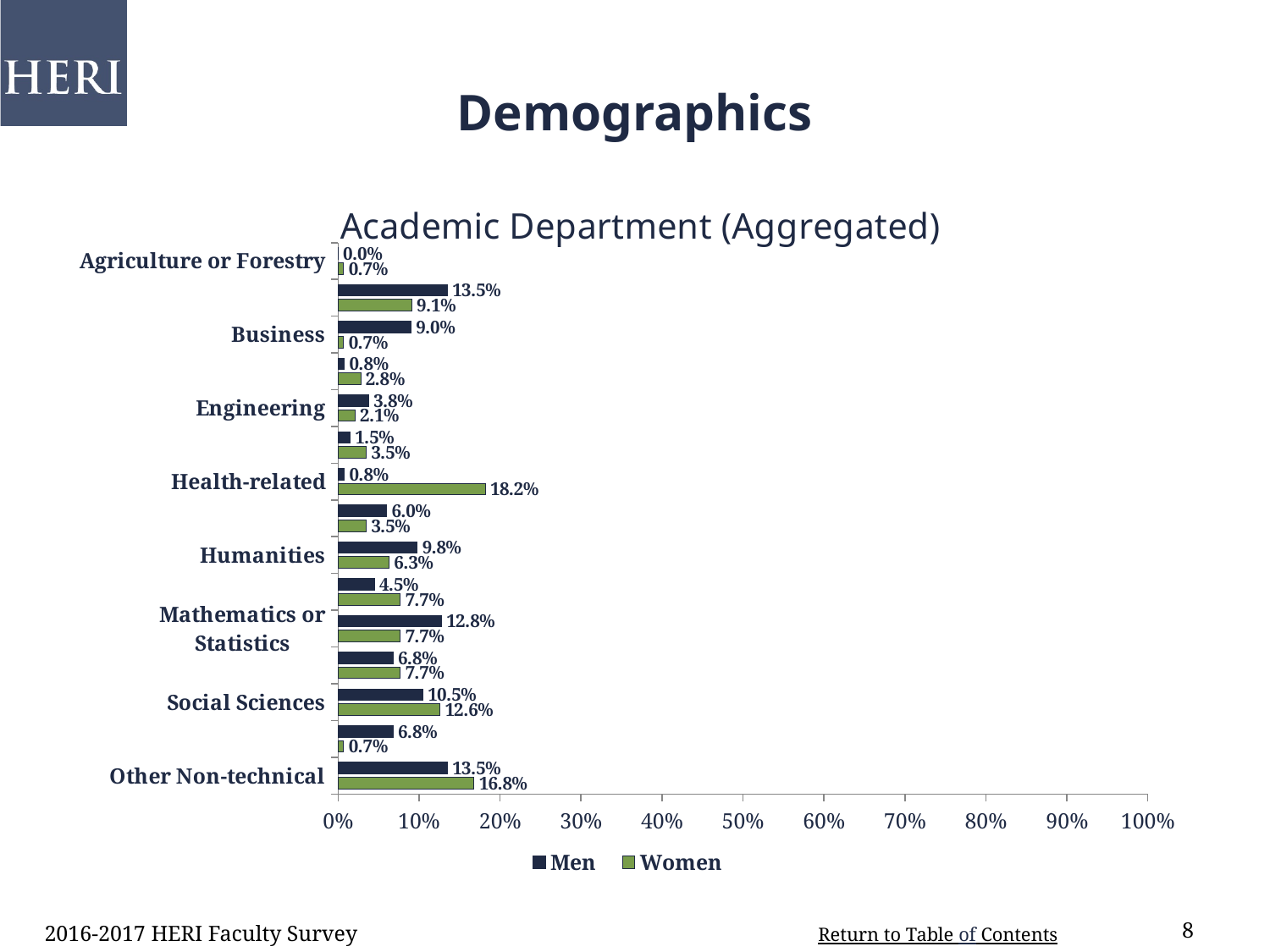
What is the value for Men in Mathematics or Statistics? 12.8% What is the value for Women in Other Non-technical? 16.8% In Social Sciences, which is larger, the value for Men or for Women? Women How many series does the legend list? 2 What kind of chart is shown on the slide? Bar chart What is the value for Men in Business? 9.0% What is the difference between the Men and Women values for Humanities? 3.5% Which labeled department has the lowest value for Men? Agriculture or Forestry What is the difference between the Women and Men values for Health-related? 17.4% Is the value for Women in Health-related greater or less than 10%? greater Which labeled department has the highest value for Women? Health-related What is the value for Women in Health-related? 18.2%